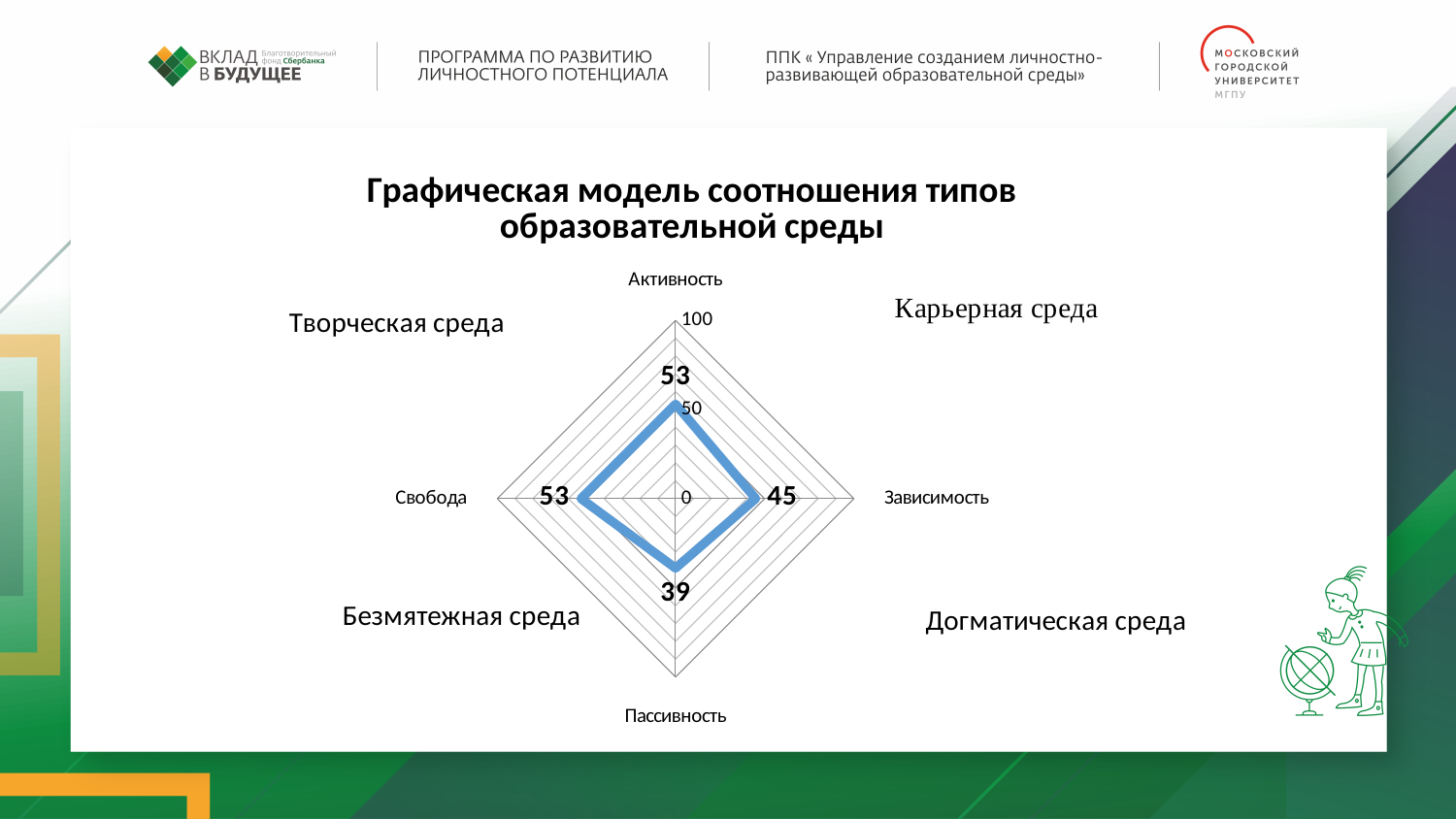
What is the difference between the values for Свобода and Зависимость? 8 What is the maximum value shown on the chart's axis scale? 100 Is the value for Пассивность greater or less than 50? less Which axis has the lowest value? Пассивность What is the value for Пассивность? 39 What kind of chart is shown on the slide? Radar chart Which is larger, the value for Зависимость or the value for Пассивность? Зависимость What is the value for Свобода? 53 How many axes (categories) does the radar chart have? 4 What is the value for Зависимость? 45 What is the value for Активность? 53 What is the difference between the values for Активность and Пассивность? 14